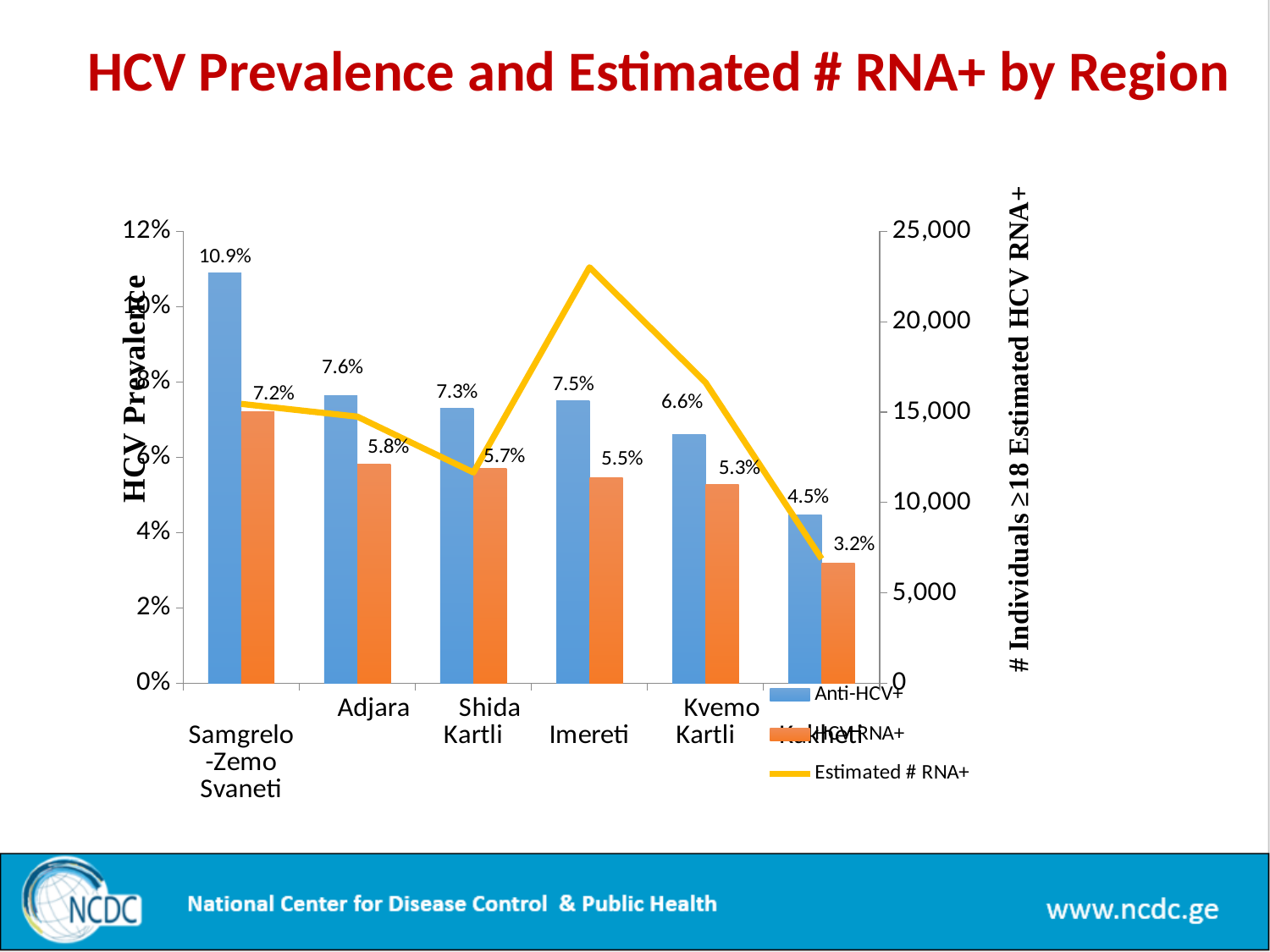
What is the difference between the Anti-HCV+ and HCV RNA+ prevalence for Samgrelo-Zemo Svaneti? 3.7% What is the HCV RNA+ prevalence for Adjara? 5.8% Which is larger, the Anti-HCV+ prevalence for Adjara or for Kvemo Kartli? Adjara What is the Anti-HCV+ prevalence for Shida Kartli? 7.3% Is the Estimated # RNA+ value for Shida Kartli greater or less than 15,000? less Is the Estimated # RNA+ value for Imereti greater or less than 20,000? greater What is the HCV RNA+ prevalence for Kvemo Kartli? 5.3% Do the HCV RNA+ bars rise or fall from left to right across the regions? fall How many series does the legend list? 3 Which region has the highest Anti-HCV+ prevalence? Samgrelo-Zemo Svaneti What is the Anti-HCV+ prevalence for Samgrelo-Zemo Svaneti? 10.9% What is the lowest HCV RNA+ prevalence value shown on the chart? 3.2%